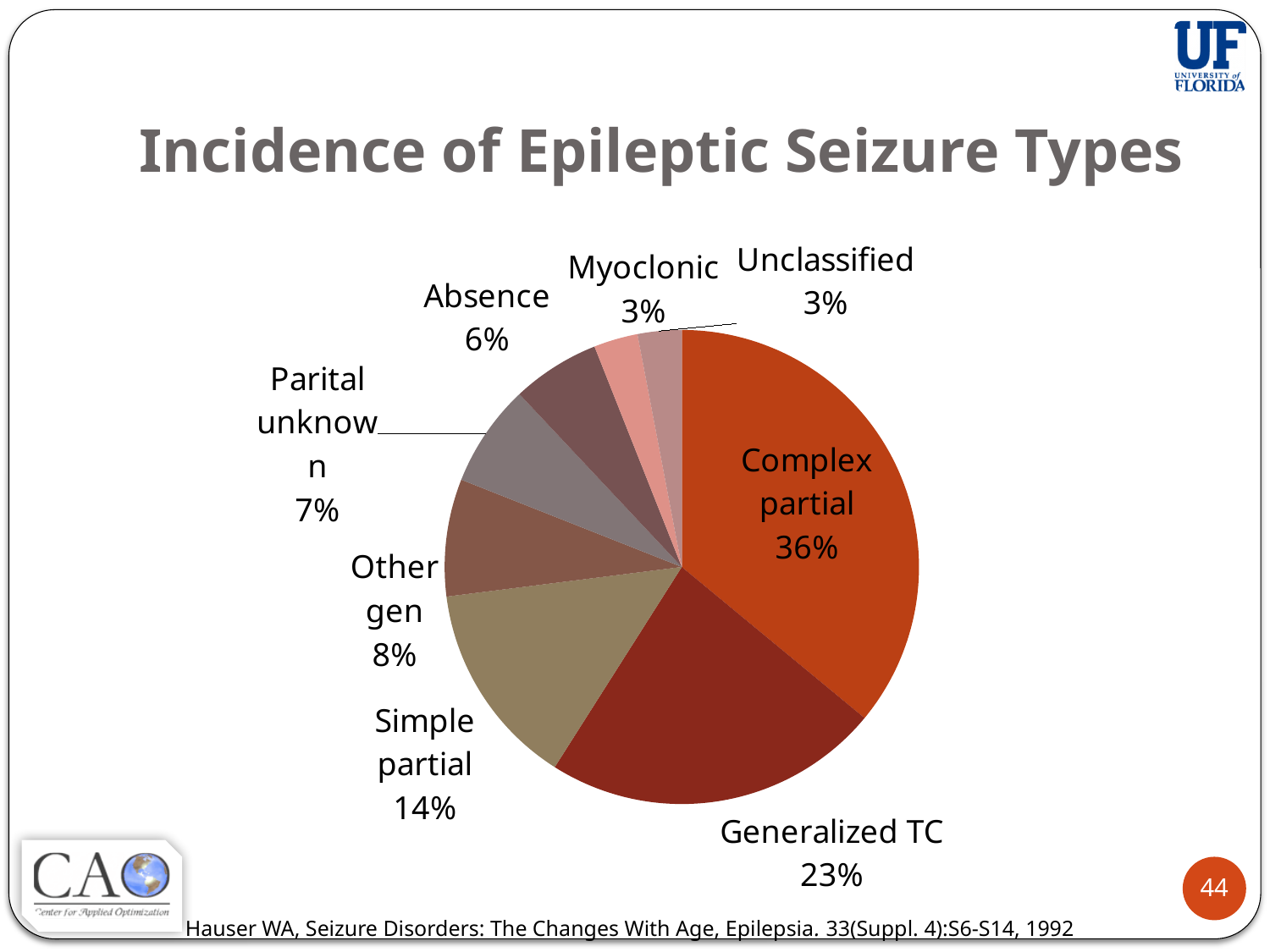
What is the value for Simple partial? 14% How many slices does the pie chart have? 8 What is the title of the chart on the slide? Incidence of Epileptic Seizure Types What is the difference between the Absence and Myoclonic shares? 3% What share of the pie does Complex partial have? 36% What is the value for Generalized TC? 23% Which seizure type has the largest slice of the pie? Complex partial What kind of chart is shown on the slide? pie chart What is the difference between the Complex partial and Generalized TC shares? 13% Which is larger, Simple partial or Other gen? Simple partial What is the value for Absence? 6% What is the value for Parital unknown? 7%